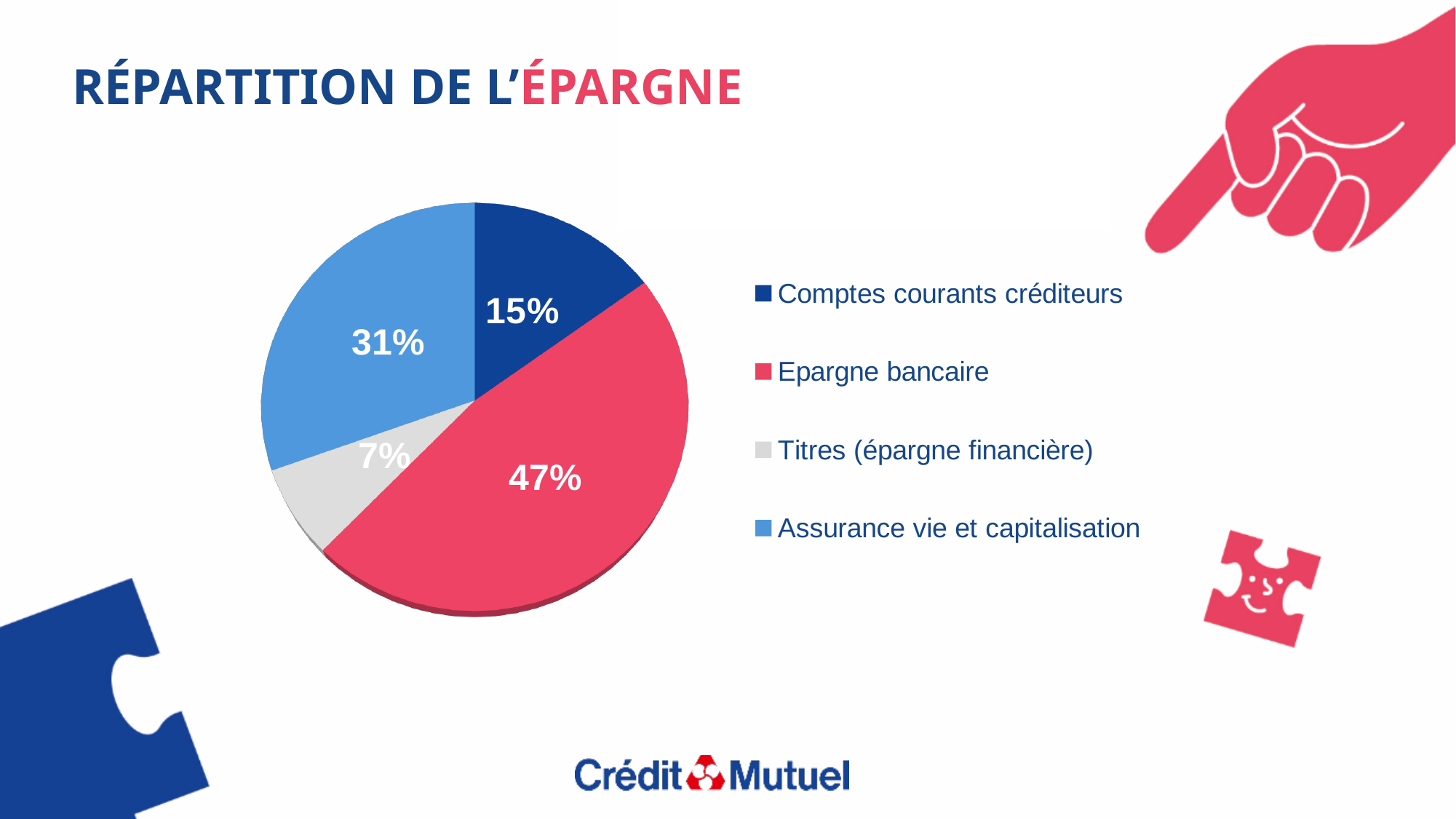
Which is larger: Comptes courants créditeurs or Titres (épargne financière)? Comptes courants créditeurs What share of savings is Epargne bancaire? 47% Which category has the smallest slice of the pie? Titres (épargne financière) Which category has the largest slice of the pie? Epargne bancaire What share of savings is Assurance vie et capitalisation? 31% What share of savings is Comptes courants créditeurs? 15% What is the title of the slide? RÉPARTITION DE L'ÉPARGNE What is the difference in percentage points between Epargne bancaire and Assurance vie et capitalisation? 16 How many categories does the pie chart show? 4 What colour is the slice for Epargne bancaire? red What kind of chart is shown on the slide? pie chart What share of savings is Titres (épargne financière)? 7%